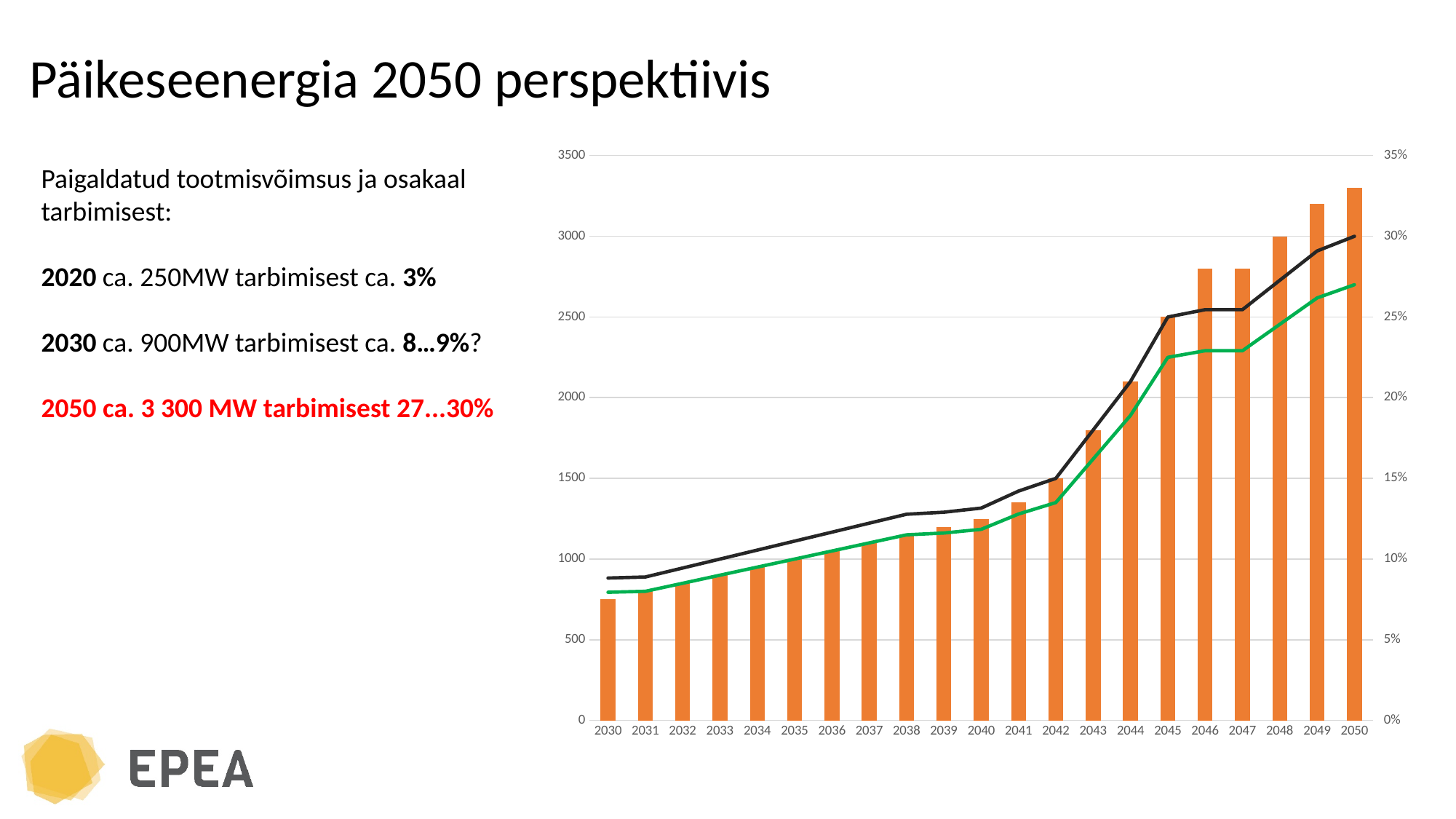
What kind of chart is shown on the slide? combination bar and line chart Is the bar value for 2046 greater or less than 2500? greater Which year has the taller bar, 2035 or 2041? 2041 How many years are shown on the x axis of the chart? 21 Is the bar value for 2050 greater or less than 3000? greater Which year has the shortest bar? 2030 Which year has the tallest bar? 2050 Is the bar value for 2043 greater or less than 1500? greater What colour are the bars in the chart? orange Do the bar values rise or fall from 2030 to 2050? rise Which year has the taller bar, 2044 or 2045? 2045